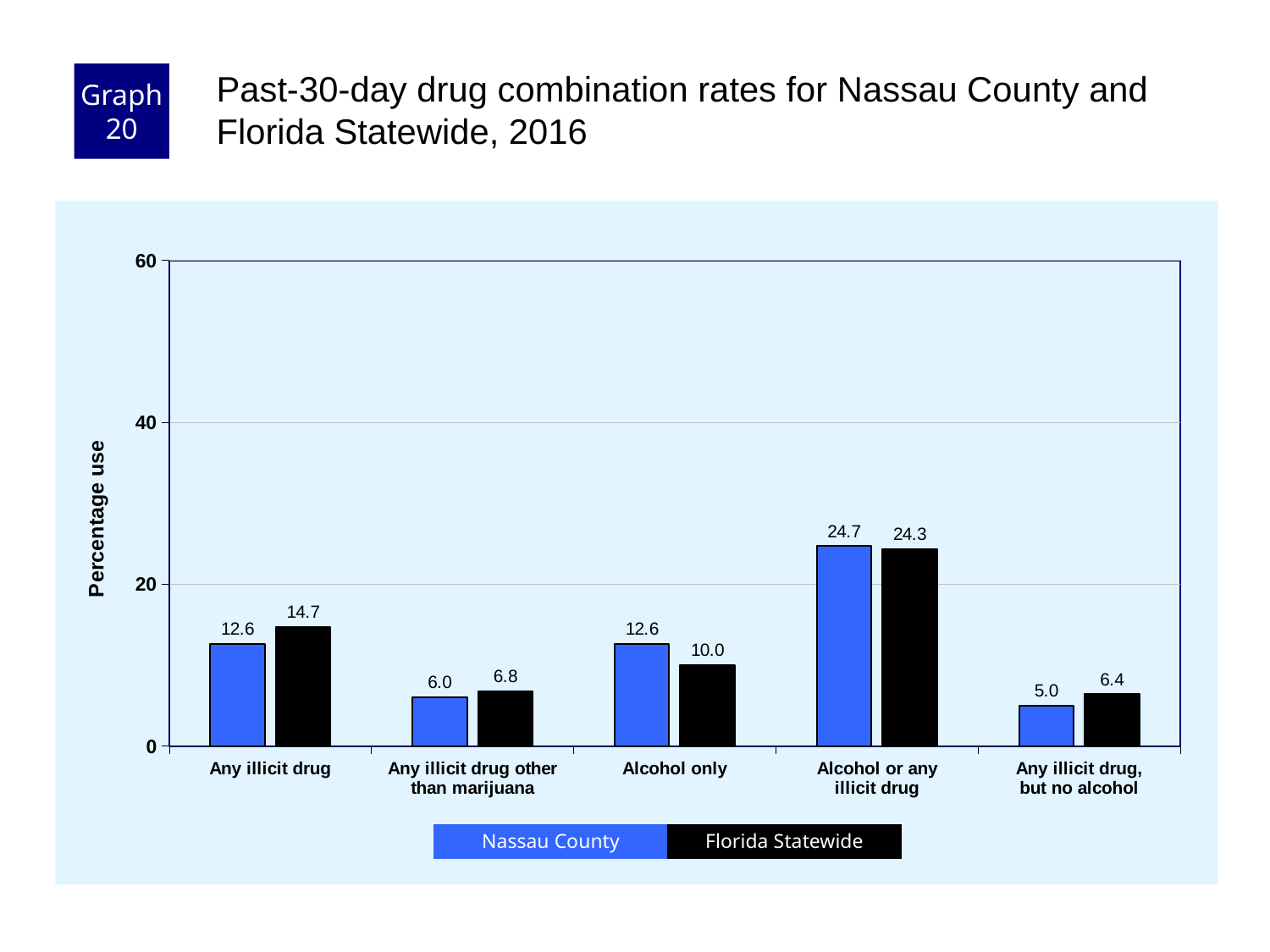
Which category has the highest Nassau County value? Alcohol or any illicit drug What is the Florida Statewide value for Alcohol only? 10.0 How many series does the legend list? 2 Is the Nassau County value for Alcohol or any illicit drug greater or less than 20? greater Which category has the lowest Florida Statewide value? Any illicit drug, but no alcohol What is the difference between the Florida Statewide and Nassau County values for Any illicit drug? 2.1 What kind of chart is shown? bar chart What is the Florida Statewide value for Any illicit drug, but no alcohol? 6.4 What is the Nassau County value for Any illicit drug? 12.6 How many categories are shown on the x axis? 5 What is the label of the y axis? Percentage use Which is larger for Alcohol only: Nassau County or Florida Statewide? Nassau County